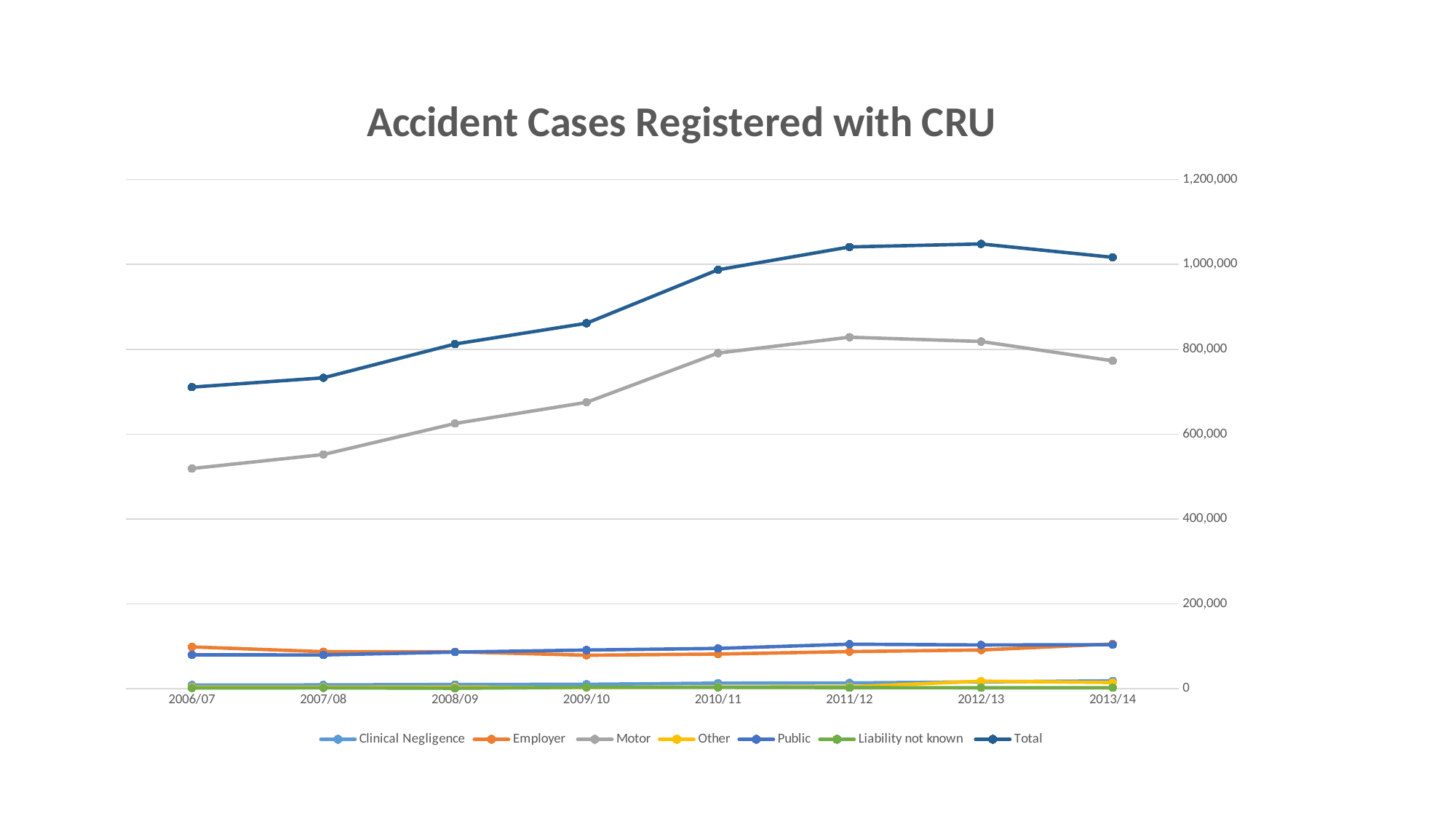
In 2006/07, which is larger, Employer or Public? Employer Does the Motor series rise or fall from 2006/07 to 2011/12? rise Is the value for Motor in 2013/14 greater or less than 800,000? less In which year is the Motor series at its lowest? 2006/07 How many series does the legend list? 7 Is the value for Total in 2006/07 greater or less than 800,000? less Is the value for Motor in 2006/07 greater or less than 600,000? less What kind of chart is shown on the slide? line chart What is the title of the chart? Accident Cases Registered with CRU Which series has the highest values across all years? Total How many years are shown along the x axis? 8